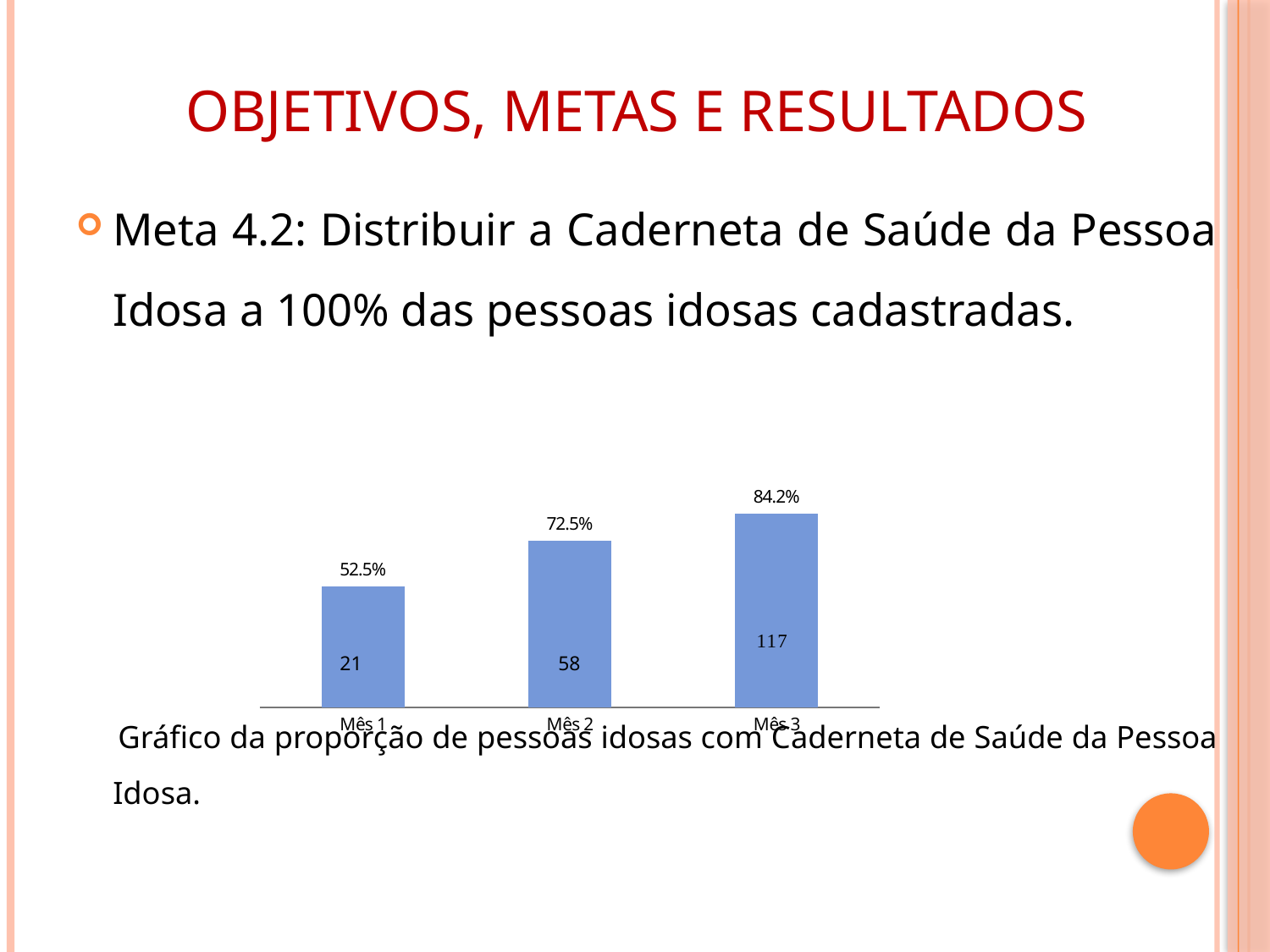
What is the difference between the numbers printed inside the bars for Mês 3 and Mês 2? 59 Do the percentages rise or fall from Mês 1 to Mês 3? rise What is the difference in percentage points between Mês 3 and Mês 1? 31.7 Which is larger, the percentage for Mês 2 or for Mês 1? Mês 2 Which month has the highest percentage? Mês 3 What number is printed inside the bar for Mês 3? 117 How many months (bars) are shown in the chart? 3 What percentage is shown above the bar for Mês 3? 84.2% Which month has the lowest percentage? Mês 1 What percentage is shown above the bar for Mês 1? 52.5% What percentage is shown above the bar for Mês 2? 72.5% What number is printed inside the bar for Mês 1? 21